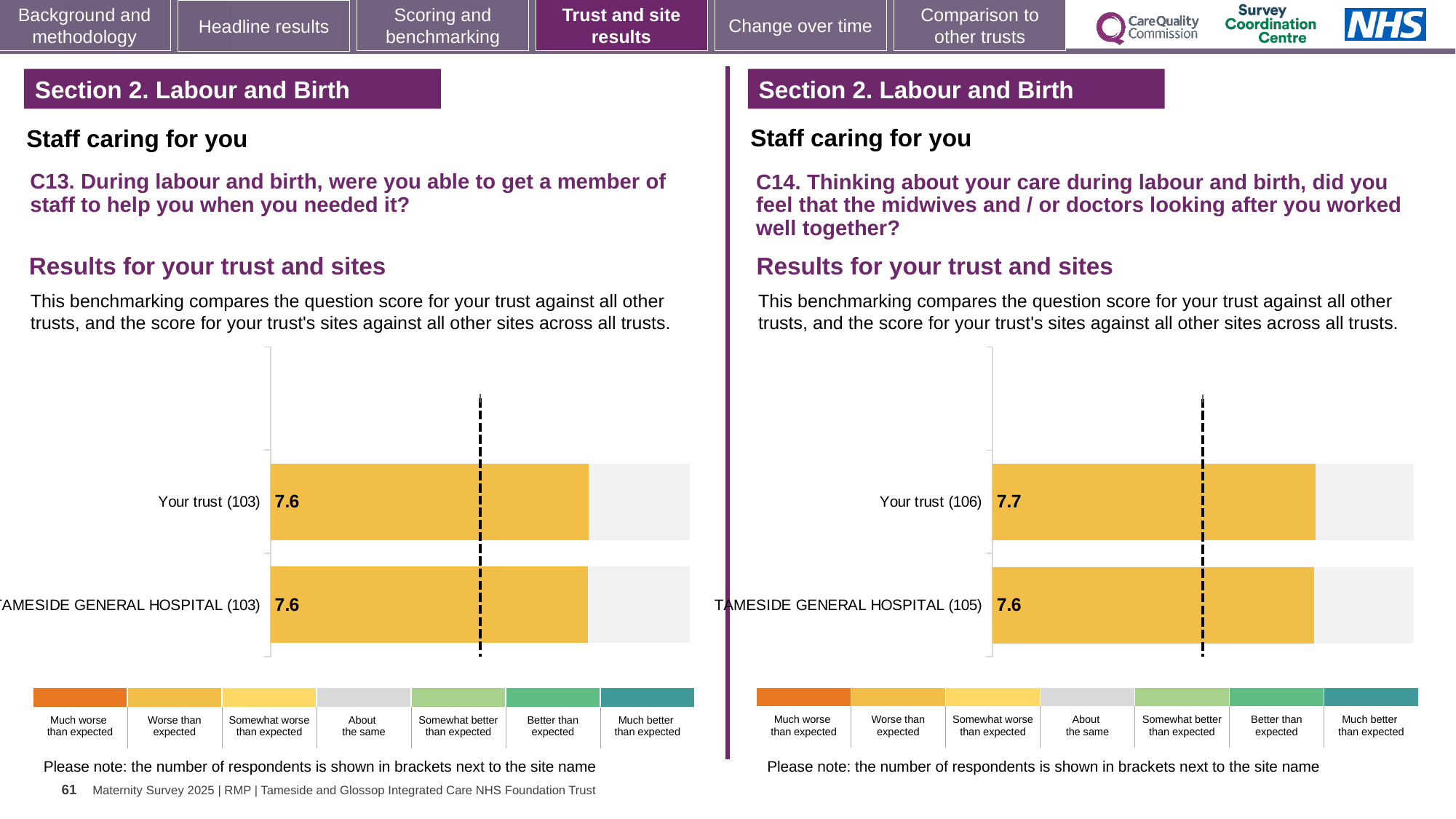
In the C14 chart on the right, what is the difference between the Your trust score and the Tameside General Hospital score? 0.1 In the C13 chart on the left, what is the score for Your trust (103)? 7.6 In the C14 chart on the right, which has the higher score, Your trust or Tameside General Hospital? Your trust In the C13 chart on the left, how many respondents are shown in brackets for Your trust? 103 In the C13 chart on the left, how many bars are plotted? 2 In the C14 chart on the right, what is the score for Tameside General Hospital (105)? 7.6 In the C13 chart on the left, what is the score for Tameside General Hospital (103)? 7.6 What type of chart is used in the C13 chart on the left? Bar chart In the C13 chart on the left, is the score for Your trust the same as the score for Tameside General Hospital? Yes In the C14 chart on the right, how many respondents are shown in brackets for Tameside General Hospital? 105 In the C14 chart on the right, how many bars are plotted? 2 In the C14 chart on the right, what is the score for Your trust (106)? 7.7